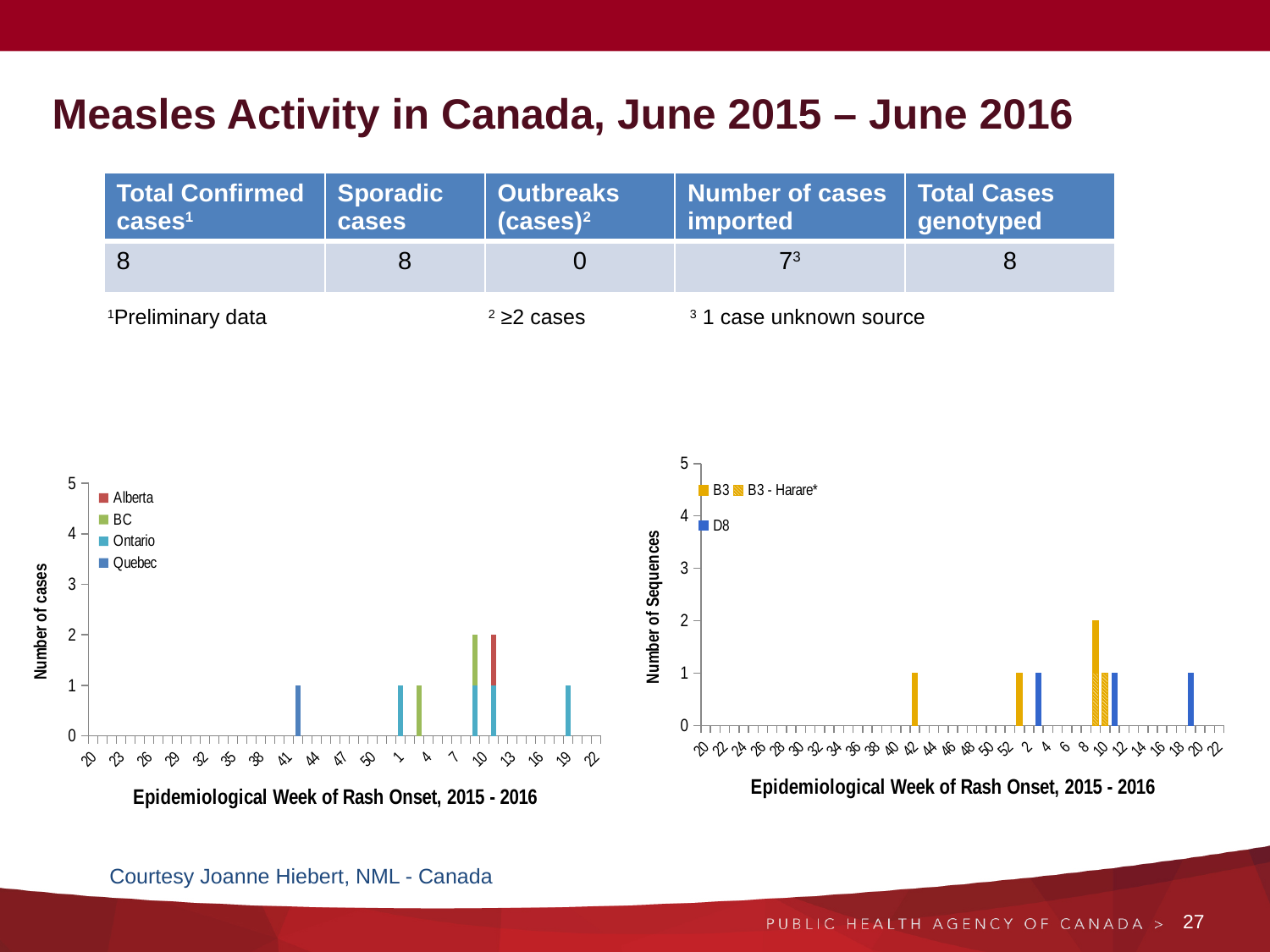
In the left chart (Number of cases), what is the highest value reached by any stacked bar? 2 What type of chart is the left chart titled 'Number of cases' by Epidemiological Week of Rash Onset? bar chart In the right chart (Number of Sequences), how many weeks have at least one sequence plotted? 7 In the left chart (Number of cases), what is the maximum value shown on the y-axis? 5 In the left chart (Number of cases), how many series does the legend list? 4 In the right chart (Number of Sequences), which genotypes are listed in the legend? B3, B3 - Harare*, D8 In the left chart (Number of cases), which provinces are listed in the legend? Alberta, BC, Ontario, Quebec What type of chart is the right chart titled 'Number of Sequences' by Epidemiological Week of Rash Onset? bar chart In the left chart (Number of cases), how many weeks have at least one case plotted? 6 In the right chart (Number of Sequences), is the tallest bar greater or less than 3? less In the right chart (Number of Sequences), what is the highest value reached by any bar? 2 In the right chart (Number of Sequences), how many series does the legend list? 3